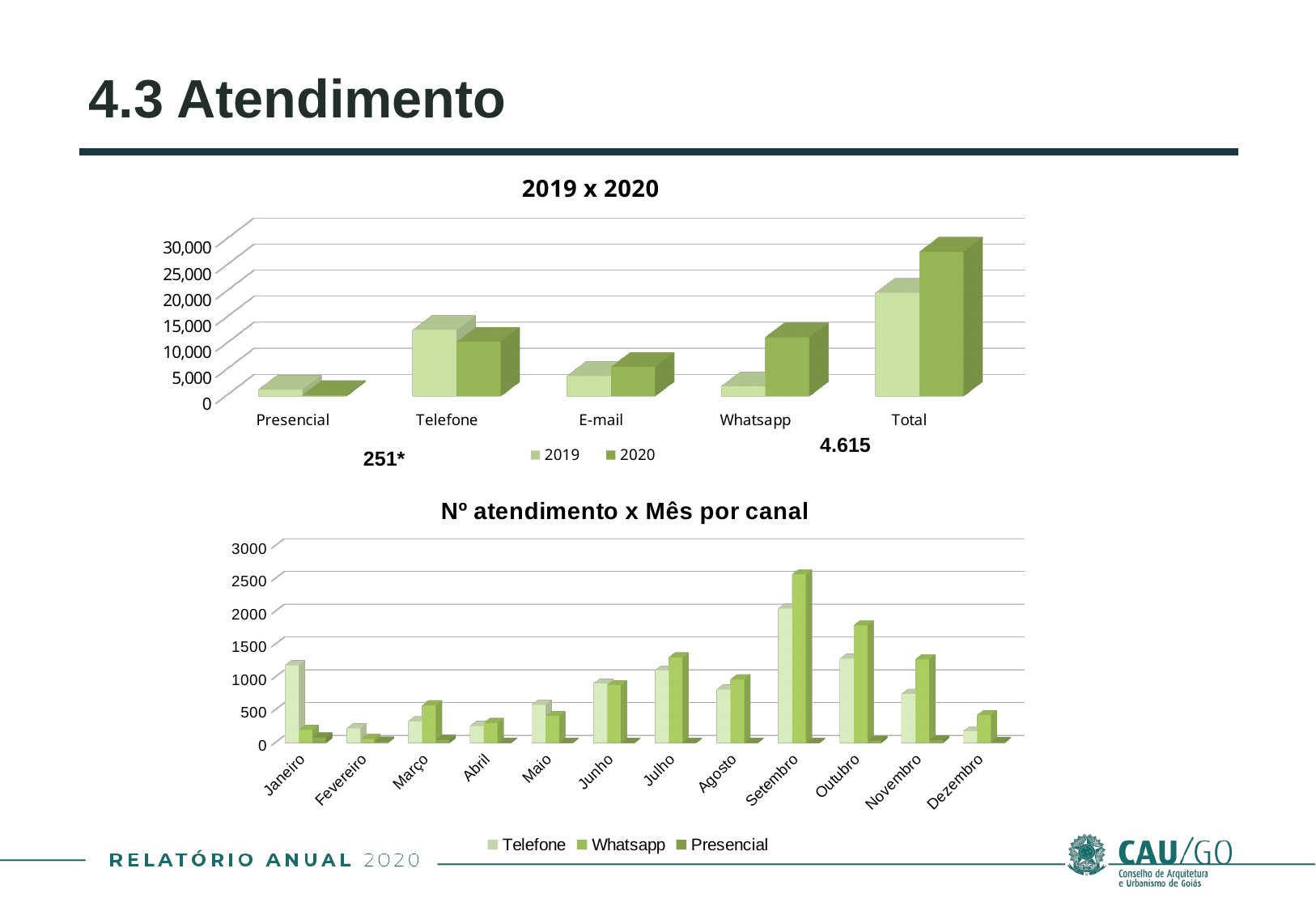
What kind of chart is the '2019 x 2020' chart? bar chart In the 'Nº atendimento x Mês por canal' chart, which is larger in Janeiro, Telefone or Whatsapp? Telefone In the 'Nº atendimento x Mês por canal' chart, how many series does the legend list? 3 In the '2019 x 2020' chart, is the 2020 value for Total greater or less than 25,000? greater In the '2019 x 2020' chart, is the 2019 value for Whatsapp greater or less than 5,000? less In the 'Nº atendimento x Mês por canal' chart, is the Telefone value for Janeiro greater or less than 1000? greater In the 'Nº atendimento x Mês por canal' chart, which month has the highest Whatsapp value? Setembro In the 'Nº atendimento x Mês por canal' chart, how many months are shown on the x axis? 12 In the '2019 x 2020' chart, how many categories are shown on the x axis? 5 In the '2019 x 2020' chart, how many series does the legend list? 2 In the '2019 x 2020' chart, which is larger for Whatsapp, the 2019 value or the 2020 value? 2020 In the '2019 x 2020' chart, which is larger for Telefone, the 2019 value or the 2020 value? 2019